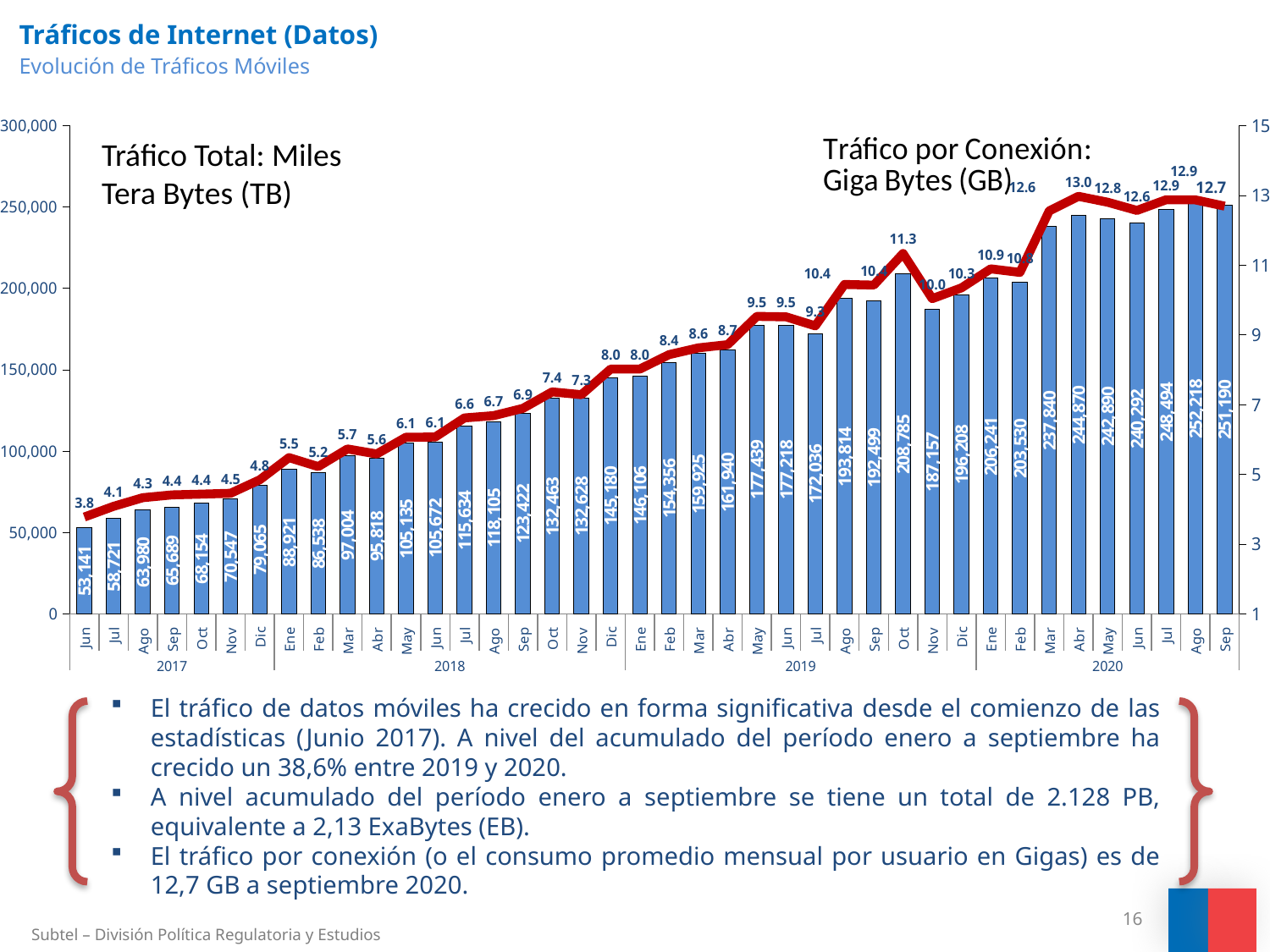
Which is larger, the total traffic for May 2019 or for June 2019? May 2019 What unit is used for the Tráfico por Conexión series? Giga Bytes (GB) What is the total traffic value shown for October 2019? 208,785 What is the highest traffic per connection value shown on the line? 13.0 What is the total mobile traffic (Tráfico Total, miles TB) shown for September 2020? 251,190 What is the traffic per connection (Tráfico por Conexión, GB) shown for June 2017? 3.8 Which month has the highest total traffic bar? Ago 2020 How many months are plotted on the chart? 40 Which month has the lowest total traffic bar? Jun 2017 What is the difference in total traffic between August 2020 (252,218) and September 2020 (251,190)? 1,028 Does the traffic per connection line generally rise or fall from June 2017 to September 2020? Rise What kind of chart is used to show the total traffic (Tráfico Total)? Bar chart